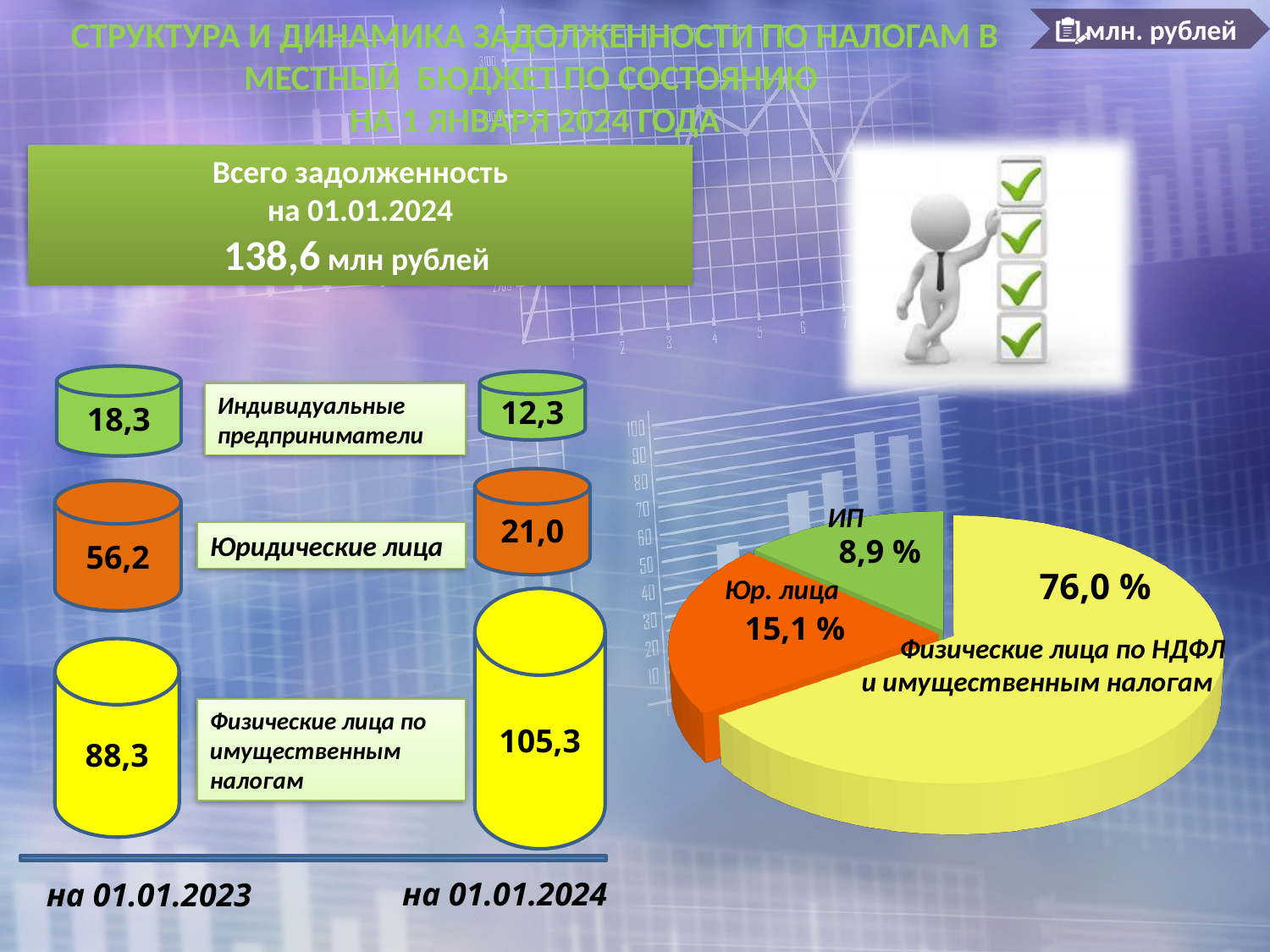
In the cylinder diagram on the left, what is the value for Юридические лица на 01.01.2024? 21,0 In the pie chart, what share is shown for ИП? 8,9 % In the pie chart, what share is shown for Физические лица по НДФЛ и имущественным налогам? 76,0 % In the pie chart, what share is shown for Юр. лица? 15,1 % In the pie chart, which share is larger: Юр. лица or ИП? Юр. лица In the cylinder diagram on the left, what is the difference between the values for Физические лица по имущественным налогам на 01.01.2024 and на 01.01.2023? 17,0 In the pie chart, which category has the smallest share? ИП How many slices does the pie chart have? 3 What kind of chart is shown on the right side of the slide? pie chart In the pie chart, which category has the largest share? Физические лица по НДФЛ и имущественным налогам In the cylinder diagram on the left, what is the value for Индивидуальные предприниматели на 01.01.2023? 18,3 In the pie chart, what is the difference between the shares of Юр. лица and ИП? 6,2 %